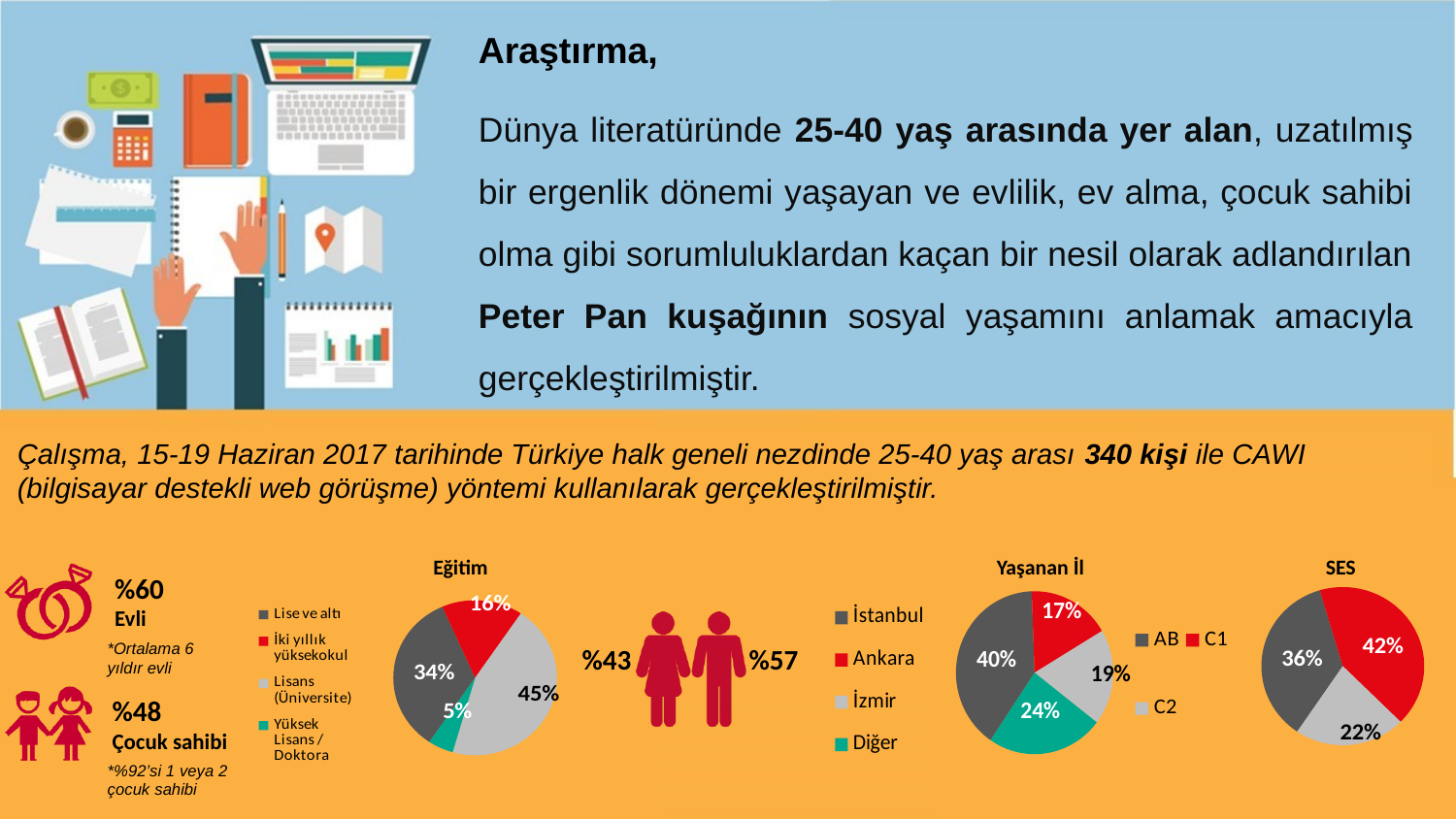
How many categories does the legend of the Eğitim chart list? 4 What type of chart is the SES chart? pie chart In the SES chart, which category has the smallest share? C2 In the Eğitim chart, which category has the smallest share? Yüksek Lisans / Doktora In the Eğitim chart, what is the difference between the Lise ve altı share and the İki yıllık yüksekokul share? 18% In the SES chart, what percentage is shown for C1? 42% In the Yaşanan İl chart, which is larger, the share for Ankara or the share for Diğer? Diğer In the Yaşanan İl chart, what is the difference between the İzmir share and the Ankara share? 2% In the Eğitim chart, what percentage is shown for Lisans (Üniversite)? 45% In the Yaşanan İl chart, what percentage is shown for İstanbul? 40% In the Yaşanan İl chart, which city has the largest share? İstanbul How many categories does the legend of the SES chart list? 3